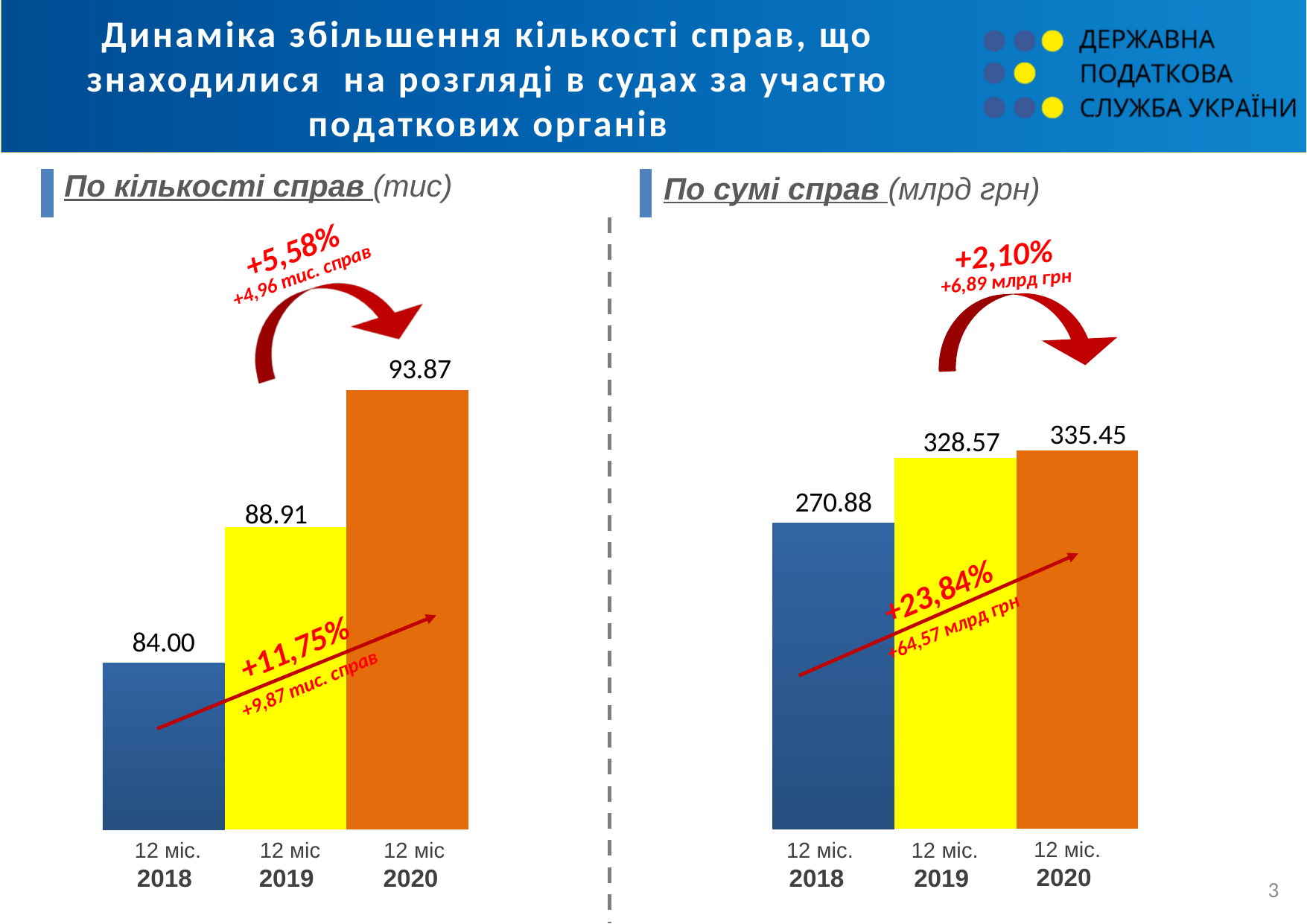
In the chart 'По сумі справ (млрд грн)', what is the value for 12 міс. 2019? 328.57 In the chart 'По сумі справ (млрд грн)', which year has the highest value? 2020 What type of chart is used in 'По кількості справ (тис)'? Bar chart In the chart 'По сумі справ (млрд грн)', what is the difference between the 2020 and 2018 values? 64.57 In the chart 'По сумі справ (млрд грн)', what is the value for 12 міс. 2018? 270.88 In the chart 'По кількості справ (тис)', which is larger: the value for 2019 or the value for 2020? 2020 In the chart 'По кількості справ (тис)', what is the value for 12 міс. 2018? 84.00 In the chart 'По кількості справ (тис)', which year has the lowest value? 2018 In the chart 'По сумі справ (млрд грн)', do the values rise or fall from 2018 to 2020? Rise How many bars are shown in the chart 'По сумі справ (млрд грн)'? 3 In the chart 'По кількості справ (тис)', what is the difference between the 2020 and 2018 values? 9.87 In the chart 'По кількості справ (тис)', what is the value for 12 міс. 2020? 93.87